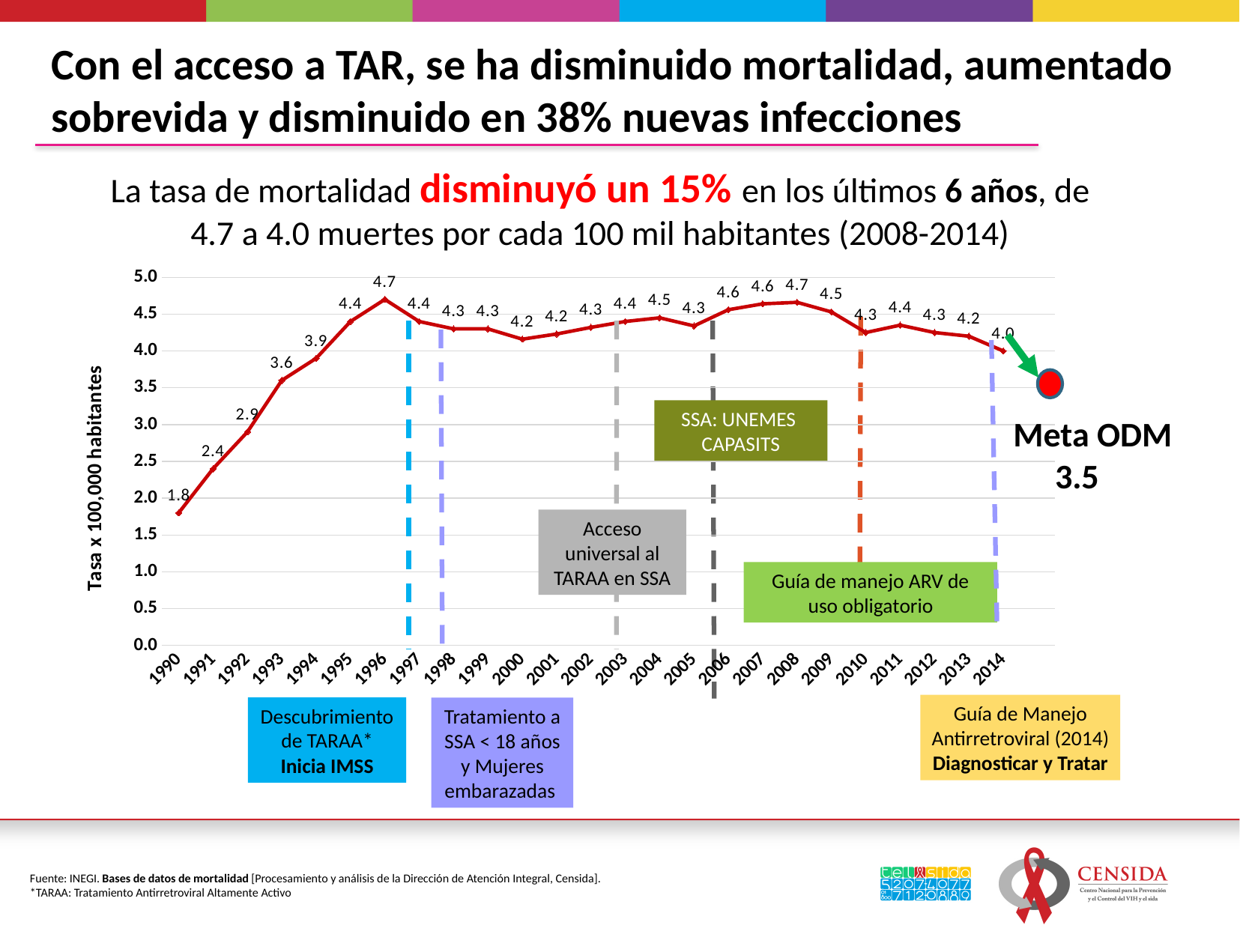
How many years are plotted on the x axis? 25 What is the label of the y axis? Tasa x 100,000 habitantes What is the highest value plotted on the line? 4.7 What is the value plotted for 2000? 4.2 What is the value plotted for 2014? 4.0 What is the value plotted for 2008? 4.7 Which year has the larger value, 1993 or 2004? 2004 What is the mortality rate value plotted for 1990? 1.8 Which year has the lowest plotted value? 1990 Do the values rise or fall from 1990 to 1996? rise What is the difference between the values for 2008 and 2014? 0.7 What kind of chart is shown on the slide? line chart